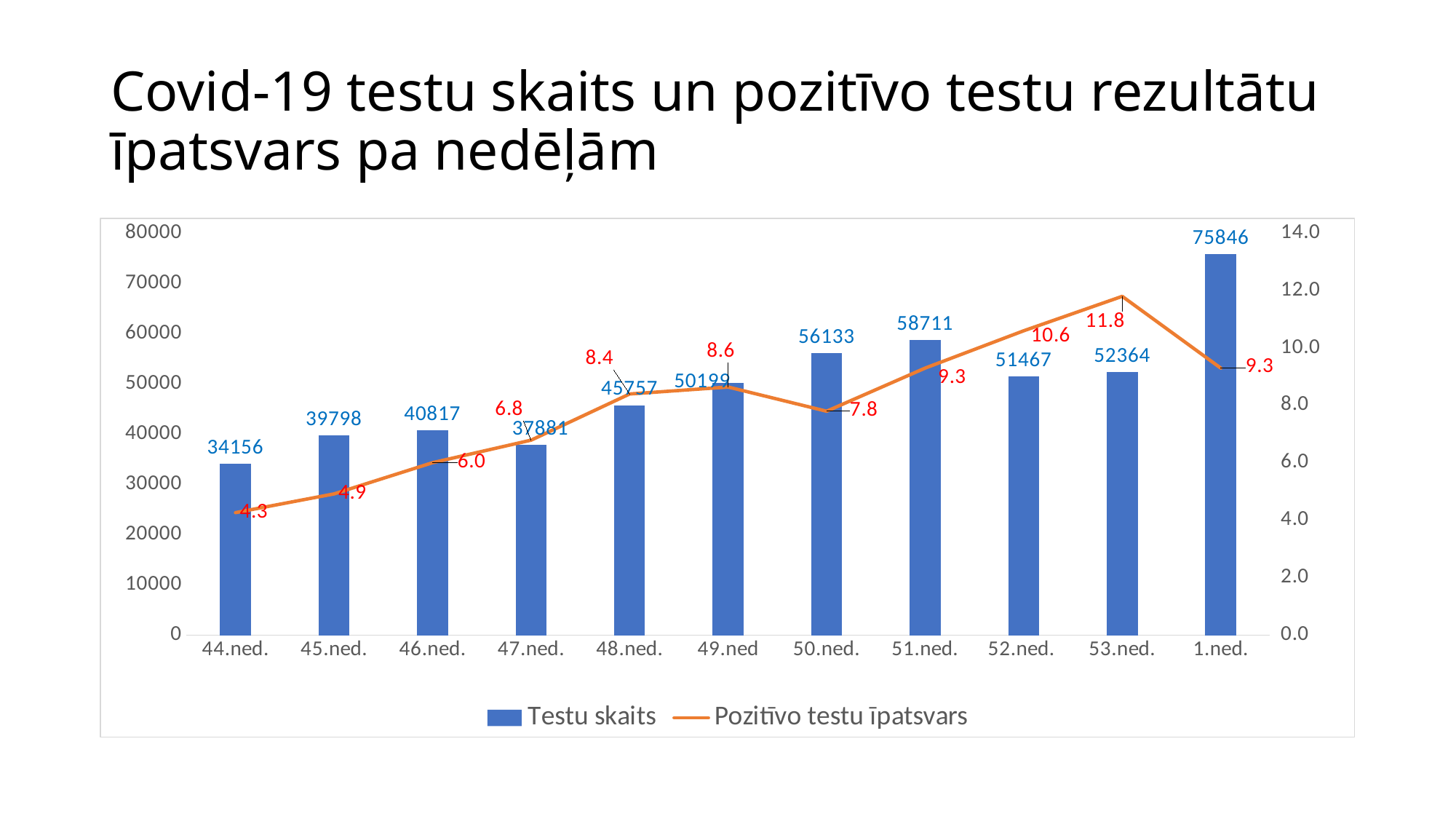
What is the Testu skaits value for 50.ned.? 56133 Which week has the highest Testu skaits? 1.ned. What is the Testu skaits value for 47.ned.? 37881 How many series does the legend list? 2 Which week has the highest Pozitīvo testu īpatsvars? 53.ned. Which week has a larger Testu skaits, 52.ned. or 53.ned.? 53.ned. How many weeks are shown on the x axis? 11 Which week has the lowest Testu skaits? 44.ned. What is the difference in Pozitīvo testu īpatsvars between 52.ned. and 51.ned.? 1.3 Does the Pozitīvo testu īpatsvars line generally rise or fall from 44.ned. to 53.ned.? rise What is the difference in Testu skaits between 1.ned. and 53.ned.? 23482 What is the Pozitīvo testu īpatsvars value for 53.ned.? 11.8